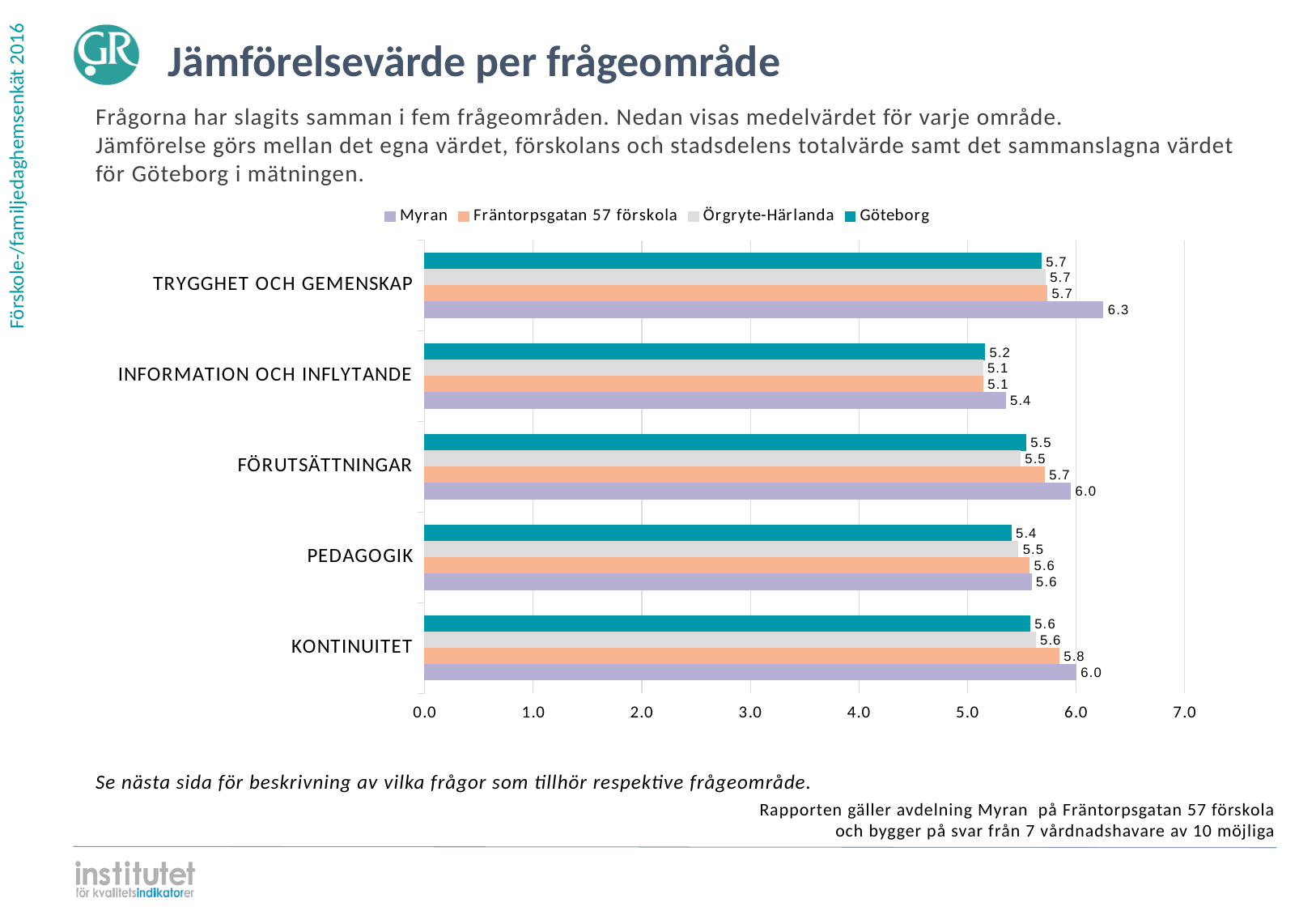
What is the value for Myran in the TRYGGHET OCH GEMENSKAP category? 6.3 In which category does Myran have its lowest value? INFORMATION OCH INFLYTANDE What is the value for Göteborg in the INFORMATION OCH INFLYTANDE category? 5.2 What is the difference between the Myran value and the Göteborg value in the TRYGGHET OCH GEMENSKAP category? 0.6 How many categories (frågeområden) are shown on the chart? 5 In which category does Myran have its highest value? TRYGGHET OCH GEMENSKAP What kind of chart is shown on the slide? Bar chart What is the value for Fräntorpsgatan 57 förskola in the KONTINUITET category? 5.8 What is the value for Örgryte-Härlanda in the PEDAGOGIK category? 5.5 Which is larger in the FÖRUTSÄTTNINGAR category: the Myran value or the Fräntorpsgatan 57 förskola value? Myran How many series does the legend list? 4 Is the value for Myran in the KONTINUITET category greater or less than 5.0? greater